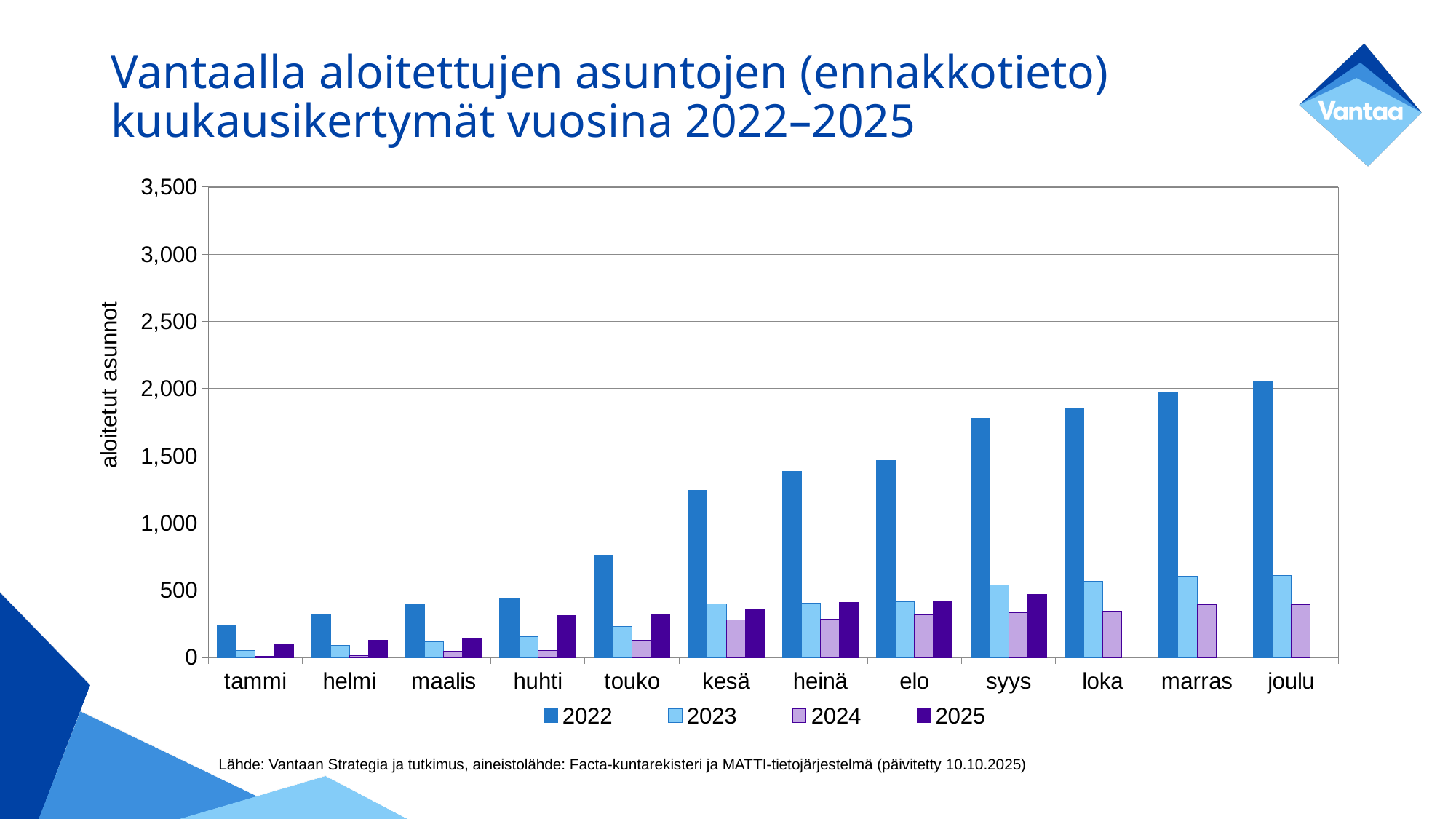
In which month is the 2022 value lowest? tammi In heinä, which series has the larger value, 2022 or 2023? 2022 How many months are shown on the x axis? 12 Is the 2022 value for tammi greater or less than 500? less In which month is the 2025 value highest? syys How many series does the legend list? 4 What kind of chart is shown on the slide? bar chart Is the 2022 value for joulu greater or less than 1,500? greater In huhti, which series has the larger value, 2024 or 2025? 2025 Is the 2023 value for joulu greater or less than 500? greater Do the 2022 values rise or fall from tammi to joulu? rise In which month is the 2022 value highest? joulu